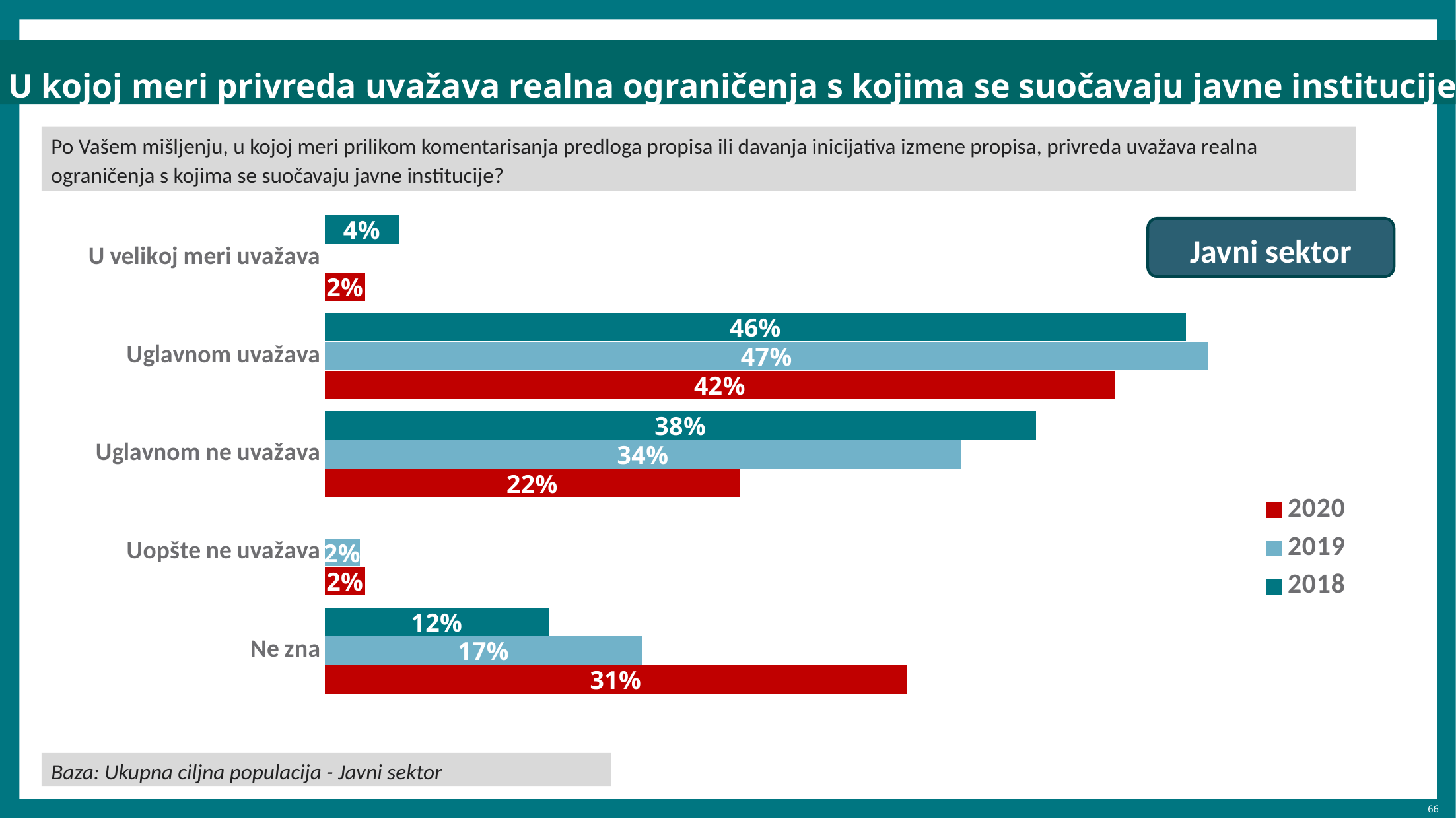
What is the 2020 value for "Uglavnom uvažava"? 42% What is the 2020 value for "Ne zna"? 31% What kind of chart is shown on the slide? bar chart Which year is shown in red in the legend? 2020 What is the 2018 value for "Ne zna"? 12% What is the difference between the 2018 and 2020 values for "Uglavnom ne uvažava"? 16% Which category has the highest 2019 value? Uglavnom uvažava How many categories are shown on the chart? 5 How many series does the legend list? 3 What is the 2019 value for "Uglavnom ne uvažava"? 34% Which is larger for "Ne zna": the 2019 value or the 2020 value? 2020